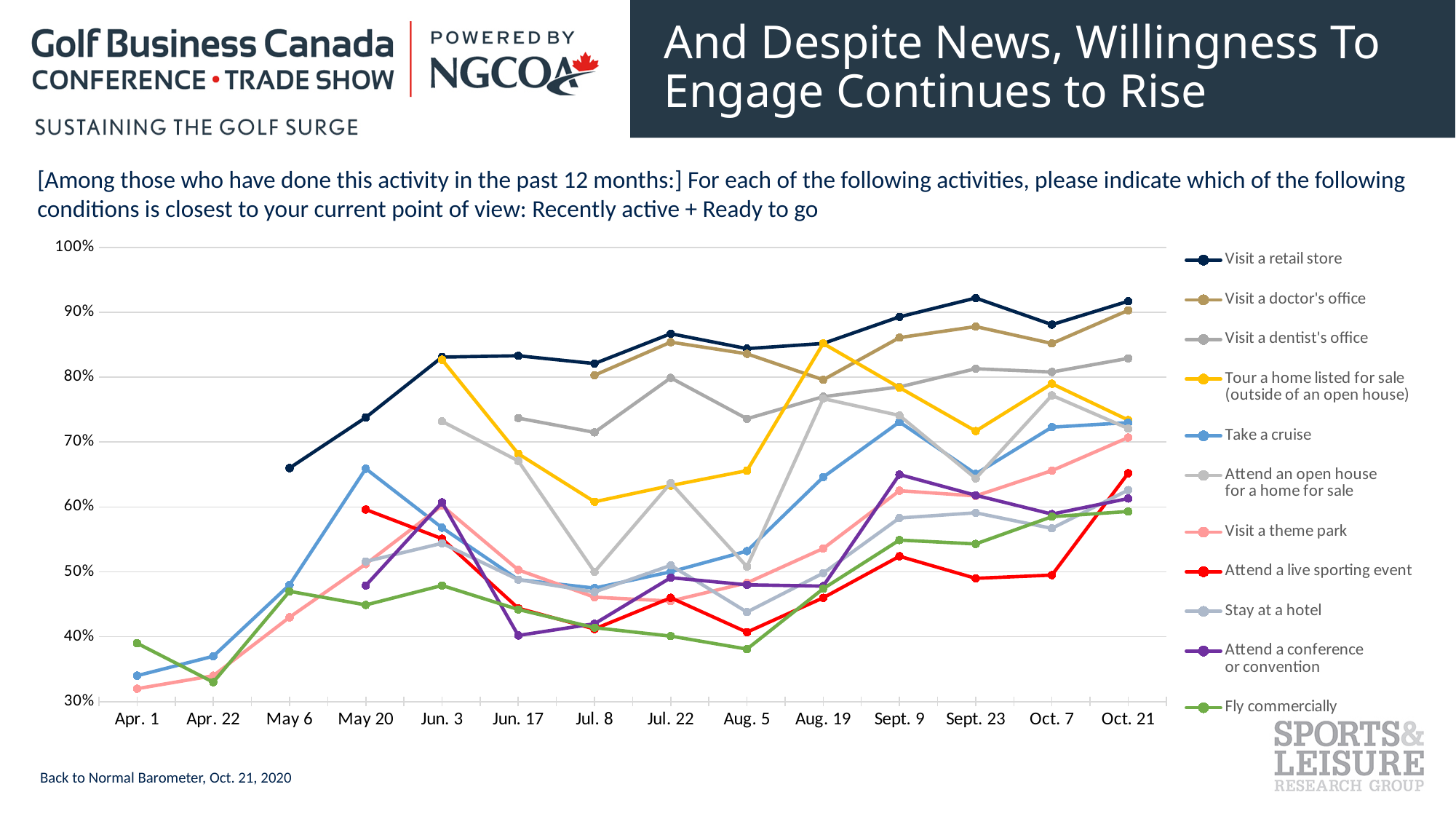
At Aug. 19, which is higher: Tour a home listed for sale or Take a cruise? Tour a home listed for sale Is the value for Fly commercially at Apr. 22 greater or less than 40%? less What kind of chart is shown on the slide? Line chart Is the value for Take a cruise at May 20 greater or less than 60%? greater Is the value for Visit a retail store at Oct. 21 greater or less than 90%? greater Does the Visit a retail store line generally rise or fall from May 6 to Oct. 21? rise Which series is drawn in yellow? Tour a home listed for sale (outside of an open house) Which activity has the lowest value at Aug. 5? Fly commercially Which activity has the highest value at Sept. 23? Visit a retail store At Sept. 9, which is higher: Attend a conference or convention or Fly commercially? Attend a conference or convention How many dates are shown along the x axis? 14 How many series does the legend list? 11